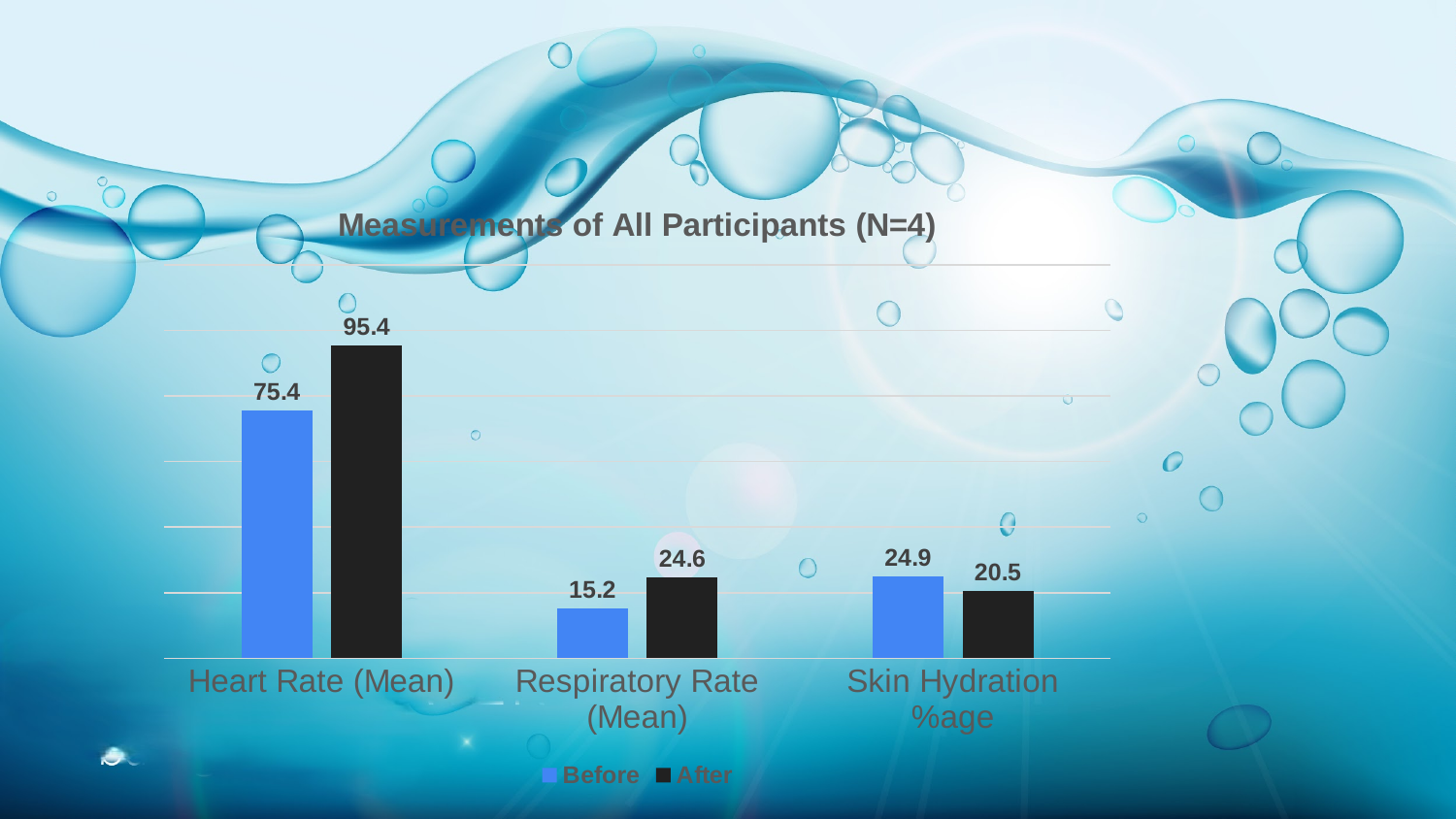
For Respiratory Rate (Mean), which is larger, the Before or the After value? After What is the After value for Heart Rate (Mean)? 95.4 What is the After value for Respiratory Rate (Mean)? 24.6 How many series does the legend list? 2 What kind of chart is shown on the slide? Bar chart Which category has the highest After value? Heart Rate (Mean) What is the difference between the Before and After values for Skin Hydration %age? 4.4 What is the Before value for Skin Hydration %age? 24.9 What is the Before value for Heart Rate (Mean)? 75.4 What is the difference between the After and Before values for Heart Rate (Mean)? 20.0 How many categories are shown on the x axis? 3 Which category has the lowest Before value? Respiratory Rate (Mean)